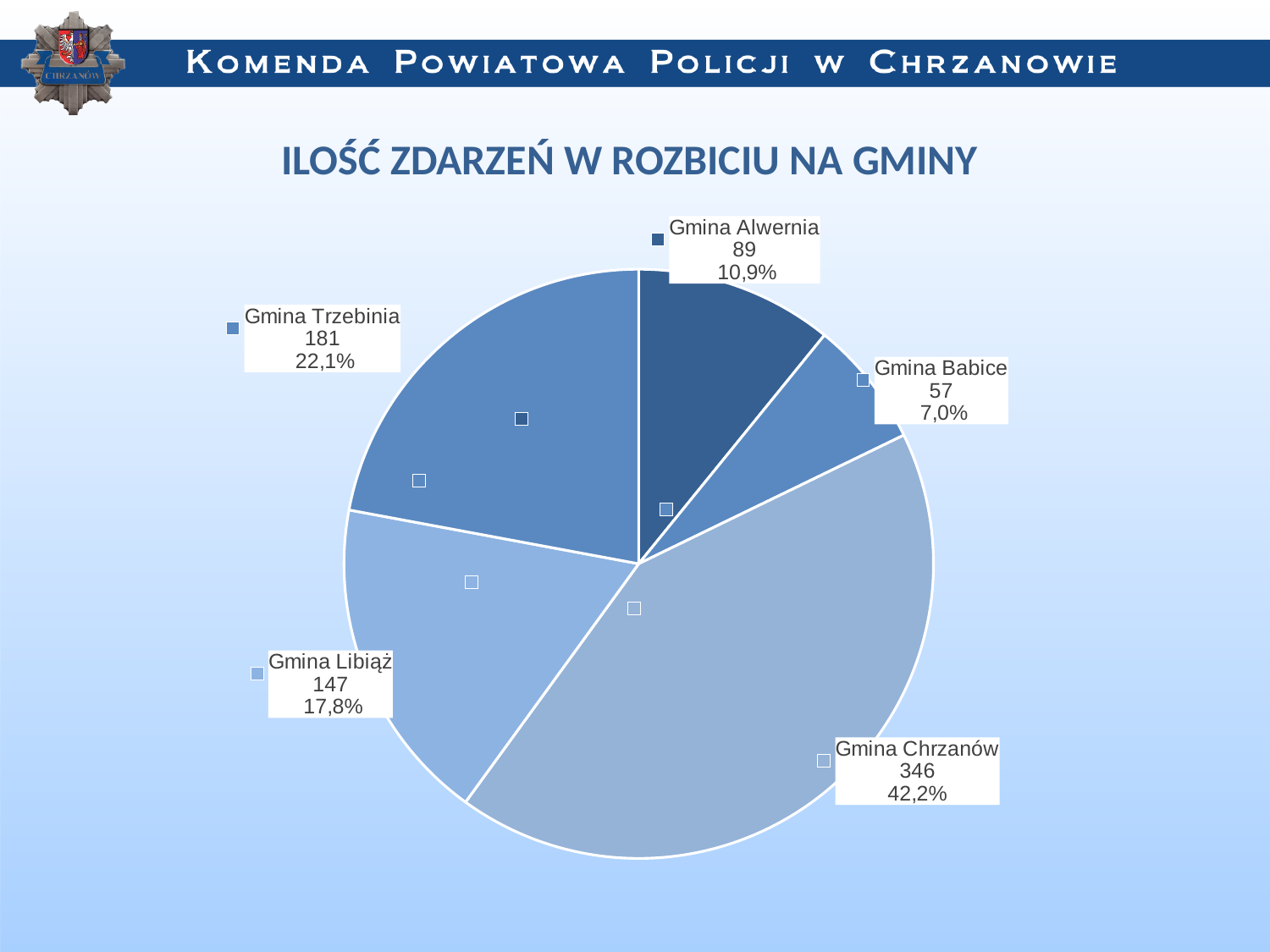
What kind of chart is shown on the slide? pie chart What is the value for Gmina Babice? 57 What share of the pie does Gmina Alwernia represent? 10,9% What is the value for Gmina Libiąż? 147 Which is larger, the value for Gmina Alwernia or Gmina Babice? Gmina Alwernia What share of the pie does Gmina Trzebinia represent? 22,1% What is the title of the chart? ILOŚĆ ZDARZEŃ W ROZBICIU NA GMINY Which gmina has the highest number of events? Gmina Chrzanów What is the value for Gmina Chrzanów? 346 Which gmina has the lowest number of events? Gmina Babice How many slices does the pie chart have? 5 What is the difference between the values for Gmina Trzebinia and Gmina Libiąż? 34